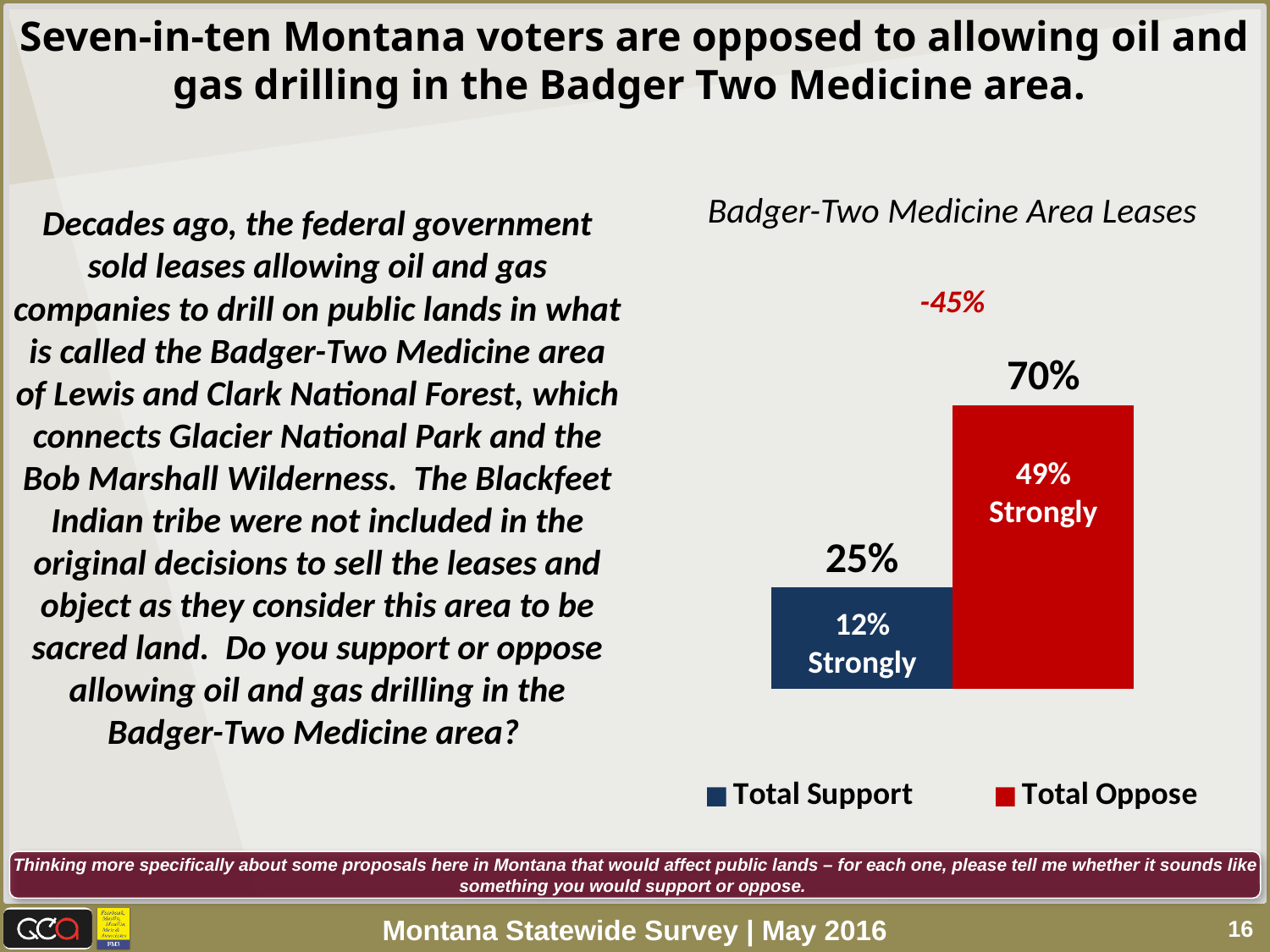
What kind of chart is shown on the slide? Bar chart What is the difference between Total Oppose and Total Support? 45% What share of voters strongly oppose, according to the label inside the Total Oppose bar? 49% Which series has the higher value, Total Support or Total Oppose? Total Oppose What net figure is printed in red above the bars? -45% What share of voters strongly support, according to the label inside the Total Support bar? 12% What is the Total Oppose value in the Badger-Two Medicine Area Leases chart? 70% What is the title of the chart? Badger-Two Medicine Area Leases What is the Total Support value in the Badger-Two Medicine Area Leases chart? 25% What colour is the Total Oppose bar? Red How many series does the legend list? 2 What is the difference between the Strongly oppose and Strongly support values? 37%